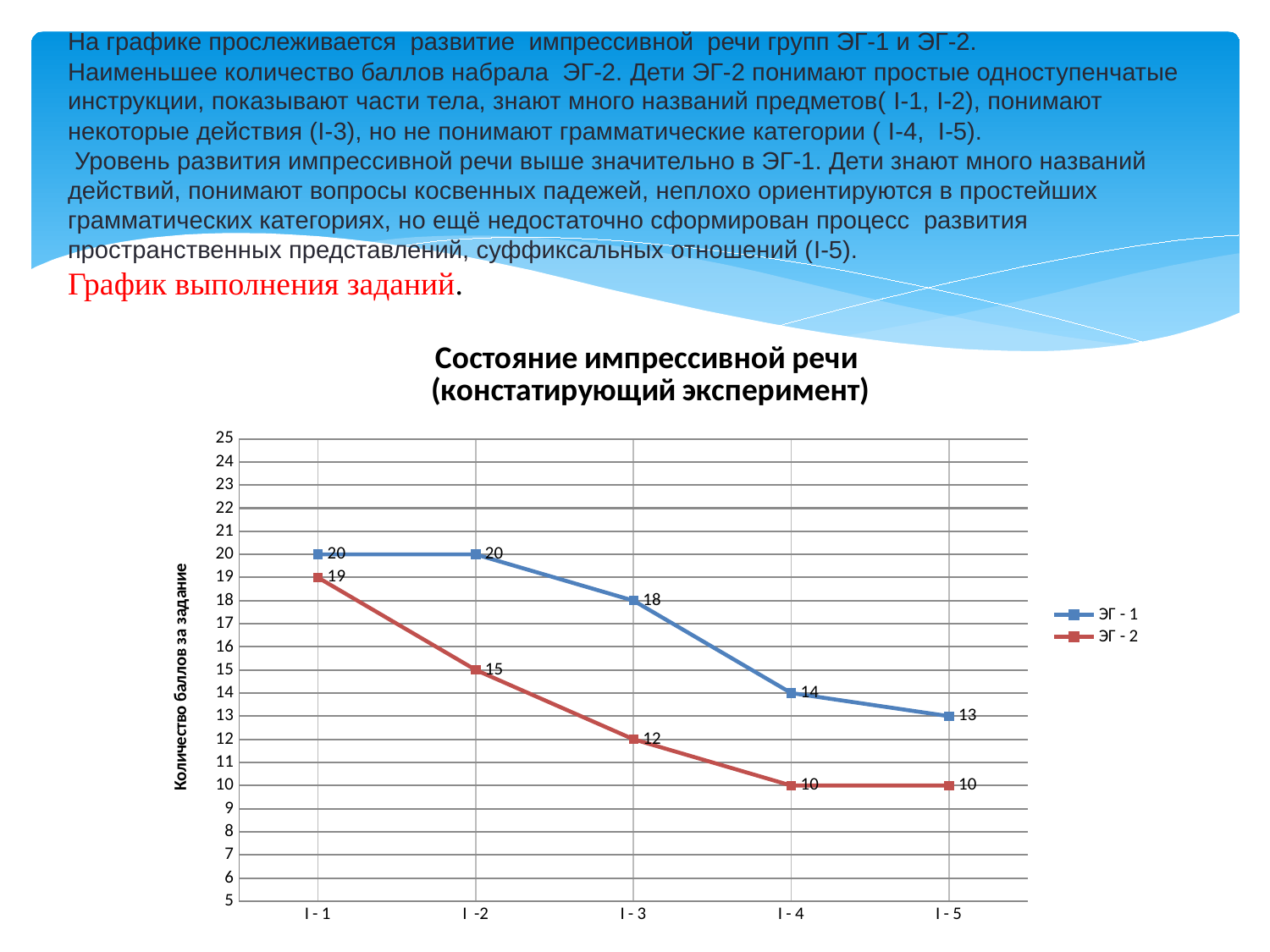
At which category does ЭГ - 1 have its lowest value? I - 5 What is the value for ЭГ - 2 at I -2? 15 What type of chart is shown on the slide? line chart Which series has the larger value at I - 3, ЭГ - 1 or ЭГ - 2? ЭГ - 1 At which category does ЭГ - 2 have its highest value? I - 1 What is the difference between ЭГ - 1 and ЭГ - 2 at I - 4? 4 What is the value for ЭГ - 1 at I - 3? 18 What is the value for ЭГ - 2 at I - 5? 10 How many categories are shown on the x axis? 5 What is the value for ЭГ - 1 at I - 5? 13 How many series does the legend list? 2 Do the values for ЭГ - 2 rise or fall from I - 1 to I - 5? fall